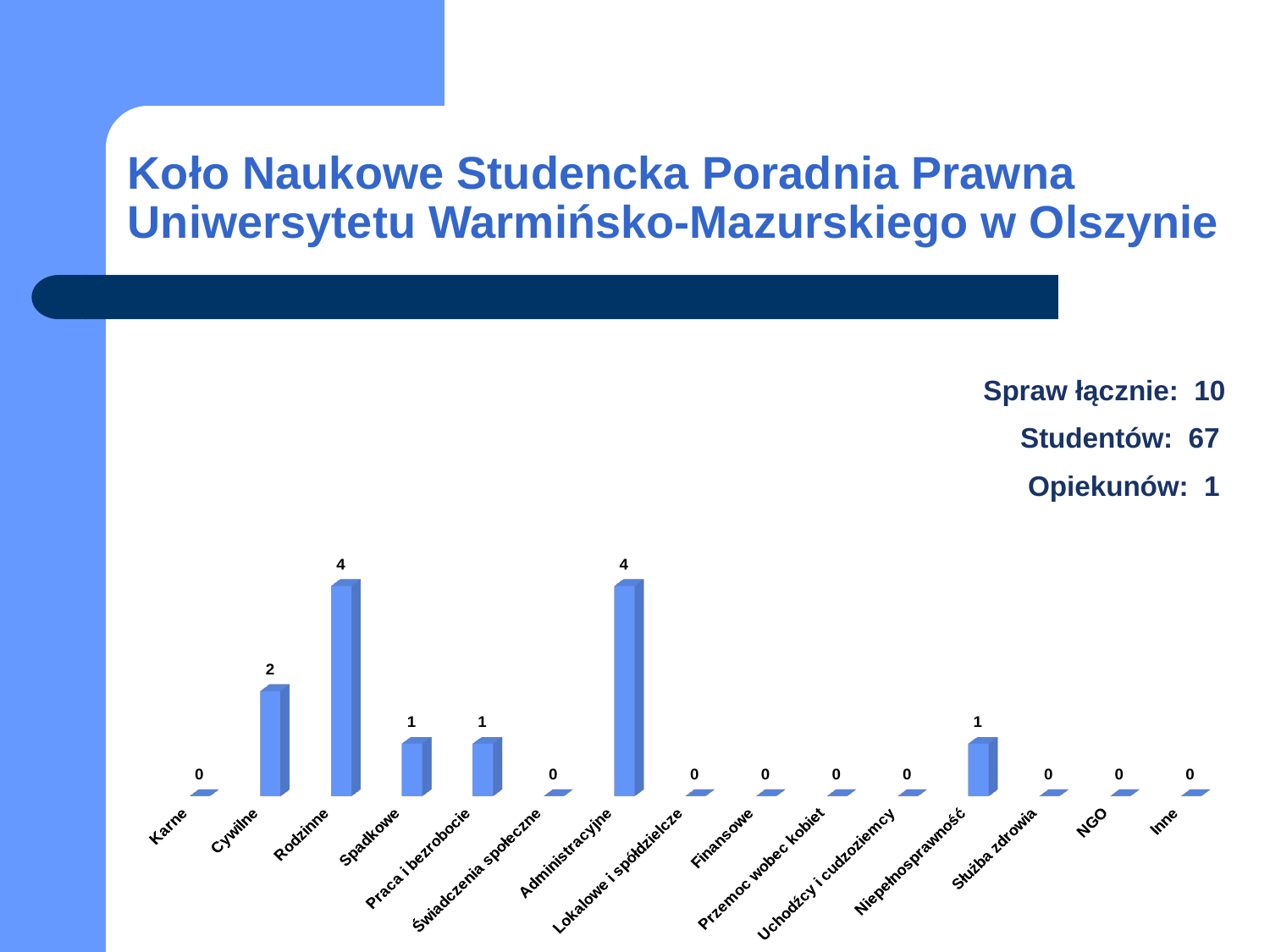
What is the value for Rodzinne? 4 What is the value for Cywilne? 2 How many categories are shown on the x axis of the chart? 15 Which is larger, the value for Cywilne or the value for Spadkowe? Cywilne Which two categories share the highest value in the chart? Rodzinne and Administracyjne What is the difference between the values for Administracyjne and Praca i bezrobocie? 3 What is the value for Karne? 0 What is the value for Administracyjne? 4 What kind of chart is shown on the slide? bar chart How many categories in the chart have a value of 0? 9 What is the difference between the values for Rodzinne and Cywilne? 2 What is the value for Niepełnosprawność? 1